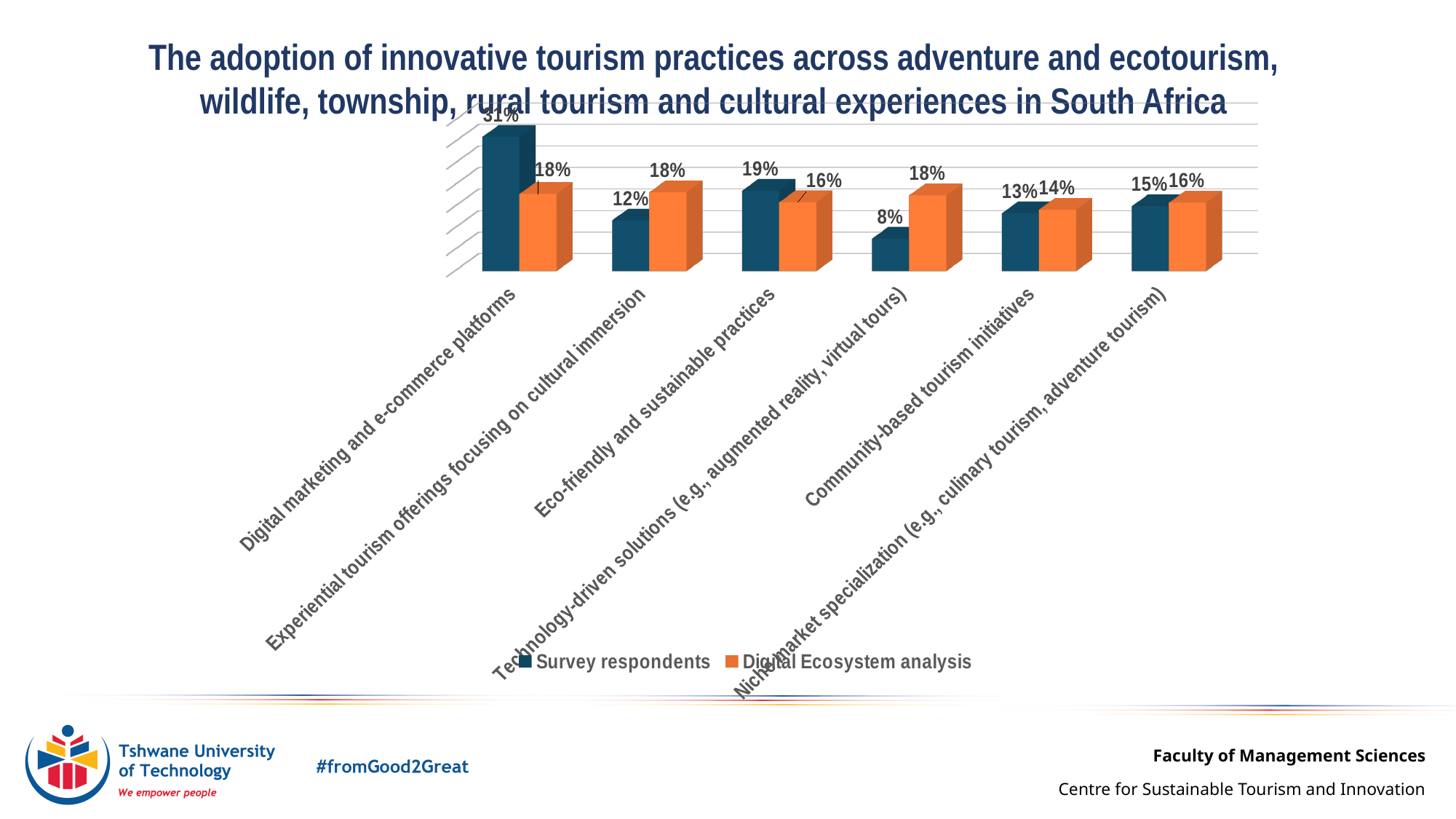
Which series is shown in orange in the legend? Digital Ecosystem analysis How many categories are shown on the x axis? 6 What is the difference between the Survey respondents and Digital Ecosystem analysis values for Digital marketing and e-commerce platforms? 13% Which category has the highest Survey respondents value? Digital marketing and e-commerce platforms For Experiential tourism offerings focusing on cultural immersion, which series has the larger value: Survey respondents or Digital Ecosystem analysis? Digital Ecosystem analysis How many series does the legend list? 2 What is the Digital Ecosystem analysis value for Technology-driven solutions (e.g., augmented reality, virtual tours)? 18% What is the difference between the Survey respondents value for Eco-friendly and sustainable practices and the Survey respondents value for Technology-driven solutions (e.g., augmented reality, virtual tours)? 11% Which category has the lowest Survey respondents value? Technology-driven solutions (e.g., augmented reality, virtual tours) What is the Survey respondents value for Digital marketing and e-commerce platforms? 31% What kind of chart is shown on the slide? Bar chart What is the Survey respondents value for Community-based tourism initiatives? 13%